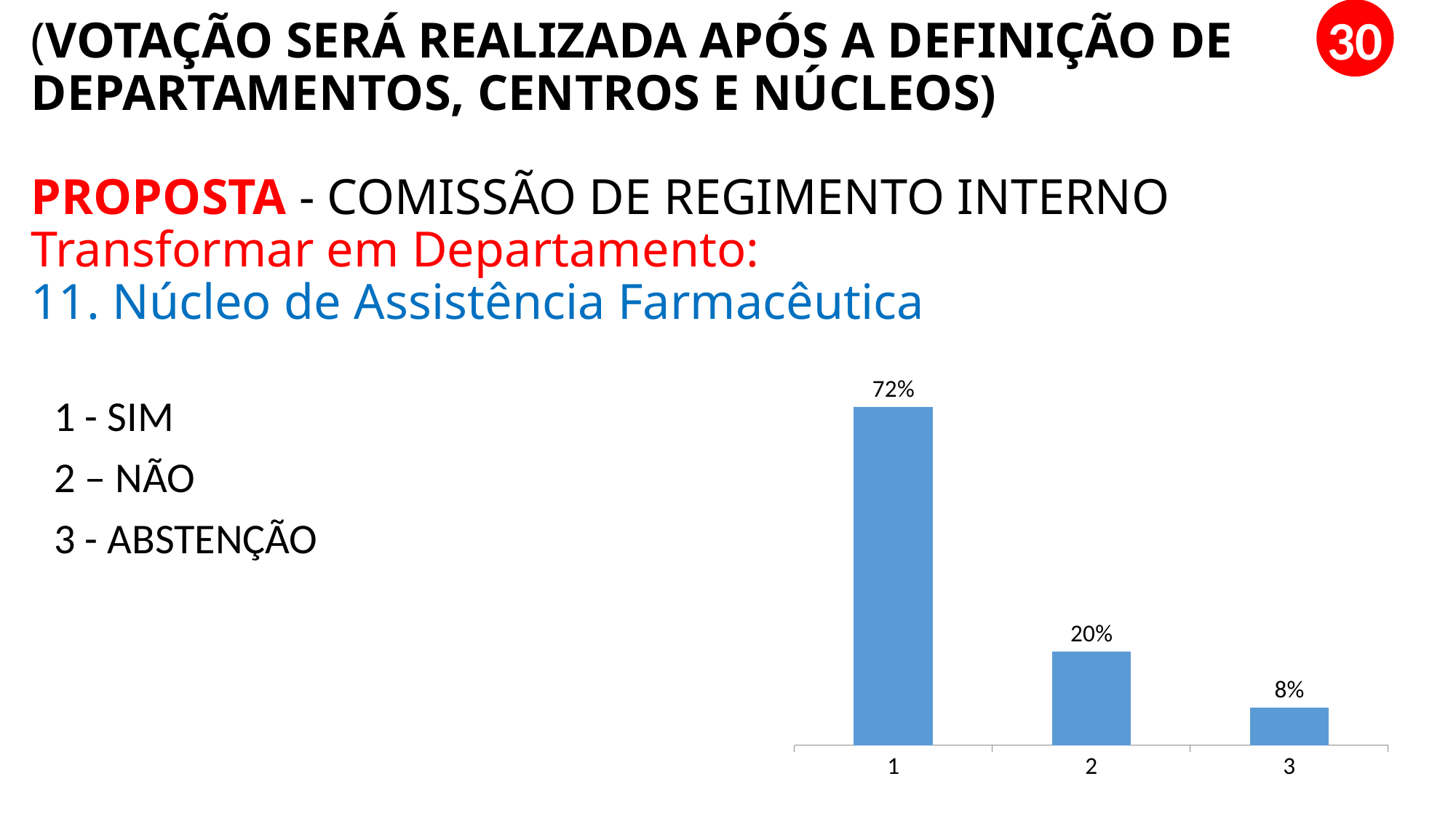
Which category has the lowest value in the bar chart? 3 Do the values rise or fall from category 1 to category 3 along the x axis? fall What colour are the bars in the chart? blue What is the difference between the values for category 1 and category 2? 52% How many categories are shown on the x axis of the bar chart? 3 What is the value shown for category 1 in the bar chart? 72% Which is larger, the value for category 2 or the value for category 3? 2 Which category has the highest value in the bar chart? 1 What kind of chart is shown on the slide? bar chart What is the difference between the values for category 2 and category 3? 12% What is the value shown for category 3 in the bar chart? 8% What is the value shown for category 2 in the bar chart? 20%